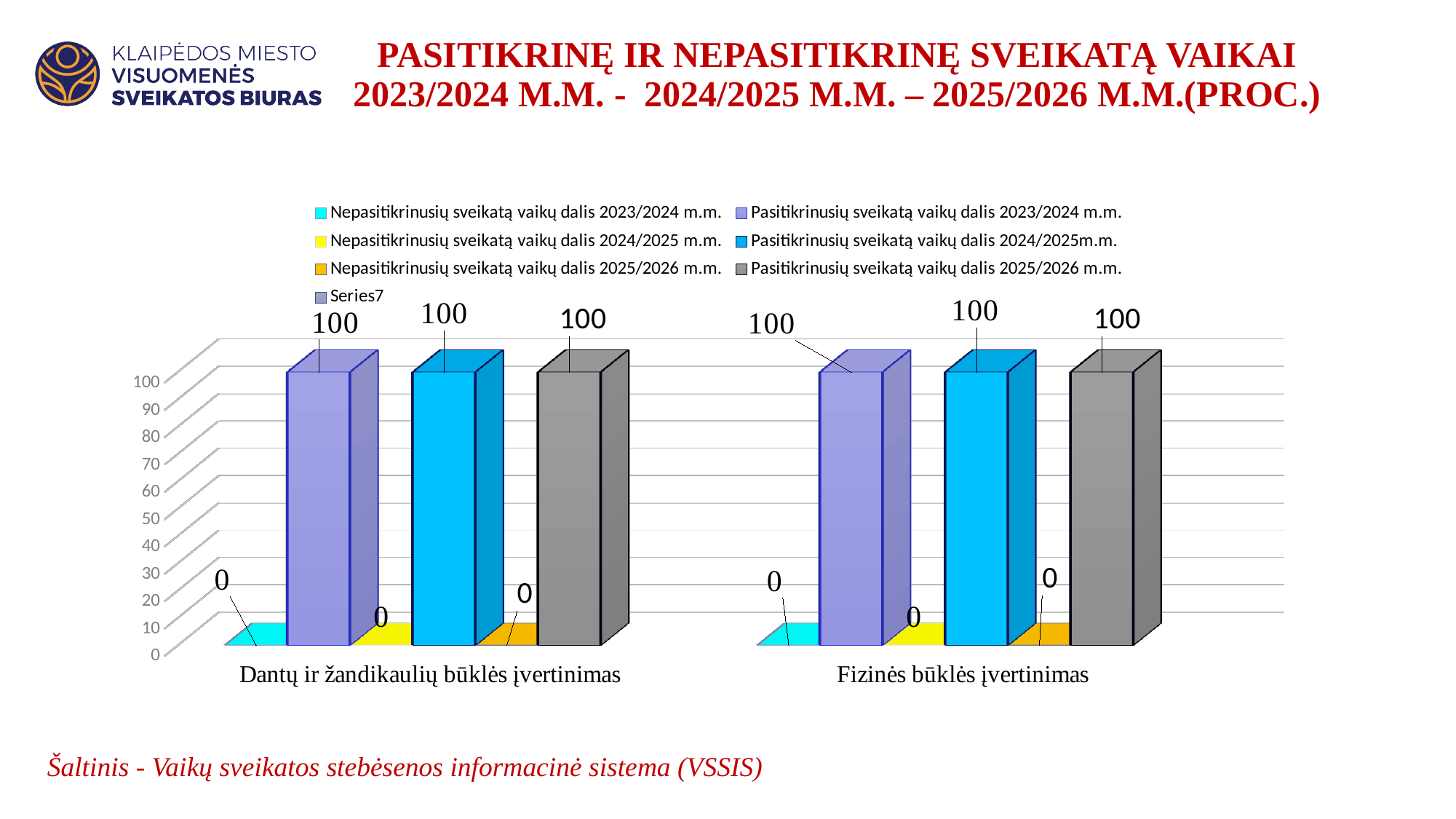
What is the value for 'Pasitikrinusių sveikatą vaikų dalis 2025/2026 m.m.' in the 'Fizinės būklės įvertinimas' category? 100 What kind of chart is shown on the slide? bar chart Which is larger in the 'Dantų ir žandikaulių būklės įvertinimas' category: 'Pasitikrinusių sveikatą vaikų dalis 2023/2024 m.m.' or 'Nepasitikrinusių sveikatą vaikų dalis 2023/2024 m.m.'? Pasitikrinusių sveikatą vaikų dalis 2023/2024 m.m. What is the value for 'Nepasitikrinusių sveikatą vaikų dalis 2025/2026 m.m.' in the 'Dantų ir žandikaulių būklės įvertinimas' category? 0 What is the highest value shown on the vertical axis of the chart? 100 What is the difference between 'Pasitikrinusių sveikatą vaikų dalis 2024/2025m.m.' and 'Nepasitikrinusių sveikatą vaikų dalis 2024/2025 m.m.' in the 'Fizinės būklės įvertinimas' category? 100 Is the value for 'Pasitikrinusių sveikatą vaikų dalis 2025/2026 m.m.' in the 'Dantų ir žandikaulių būklės įvertinimas' category greater or less than 50? greater What is the value for 'Pasitikrinusių sveikatą vaikų dalis 2023/2024 m.m.' in the 'Dantų ir žandikaulių būklės įvertinimas' category? 100 What is the source cited below the chart? Vaikų sveikatos stebėsenos informacinė sistema (VSSIS) How many categories are shown on the x axis of the chart? 2 What is the value for 'Nepasitikrinusių sveikatą vaikų dalis 2024/2025 m.m.' in the 'Fizinės būklės įvertinimas' category? 0 How many series does the chart legend list? 7